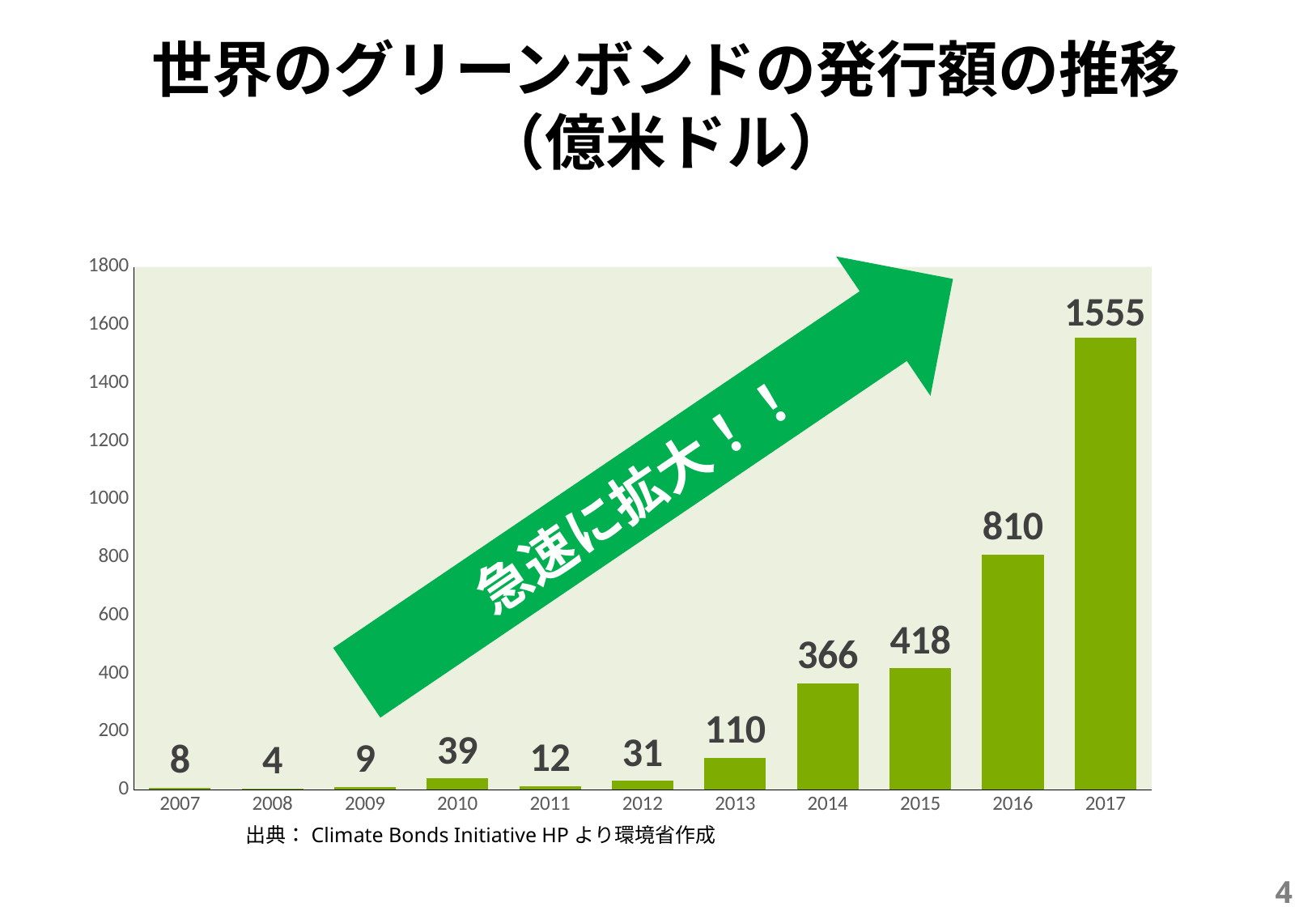
How many years are shown on the x axis? 11 What is the difference between the values for 2015 and 2014? 52 What is the difference between the values for 2017 and 2016? 745 What is the value for 2013? 110 Which year has the highest value? 2017 Which is larger, the value for 2010 or the value for 2011? 2010 What is the value for 2017? 1555 What is the value for 2008? 4 Which year has the lowest value? 2008 What kind of chart is shown on the slide? bar chart Do the values generally rise or fall from 2012 to 2017? rise Is the value for 2016 greater or less than 1000? less